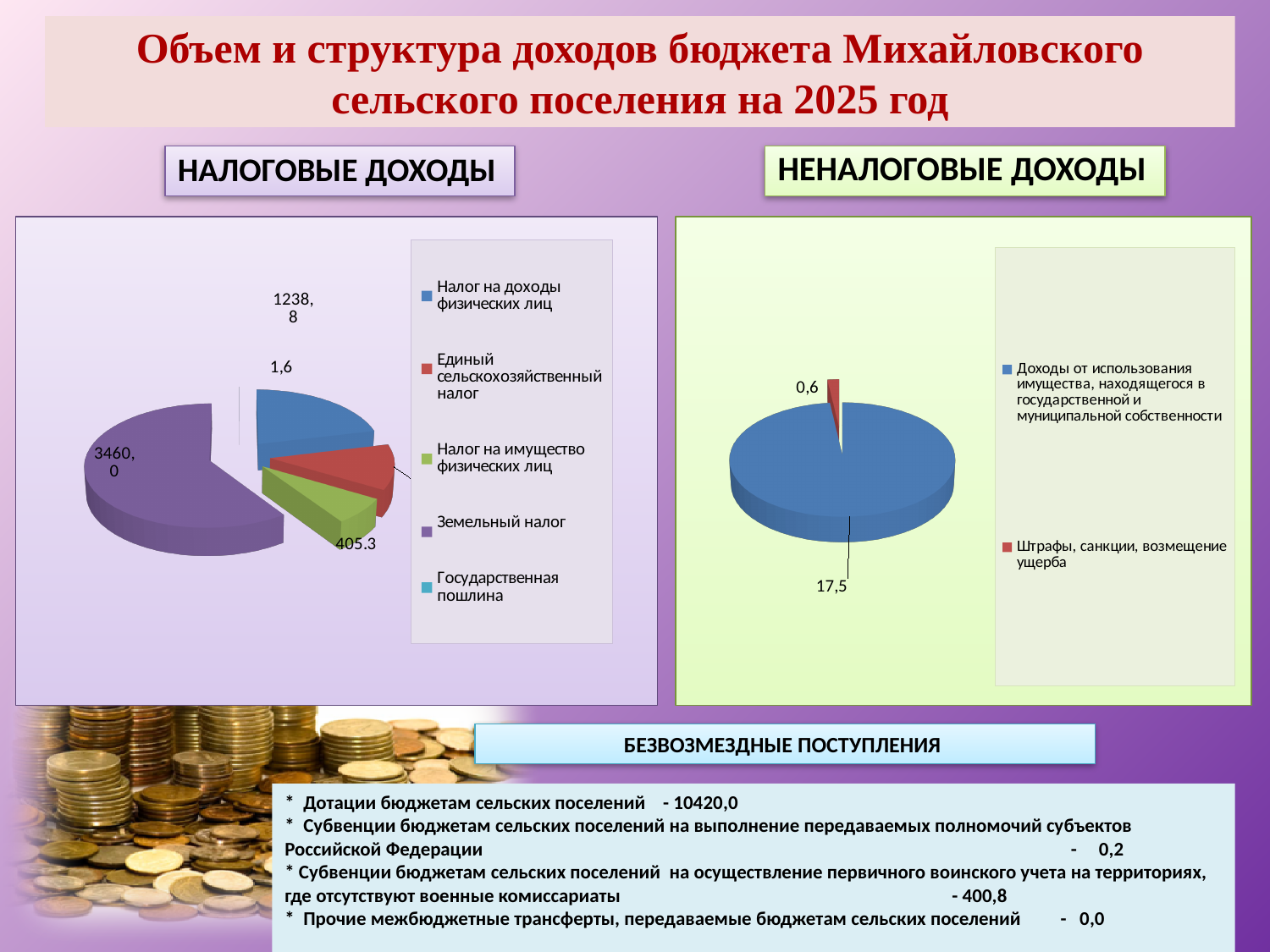
In the НЕНАЛОГОВЫЕ ДОХОДЫ chart, what is the total of the two slices? 18,1 In the НАЛОГОВЫЕ ДОХОДЫ chart, how many entries does the legend list? 5 In the НЕНАЛОГОВЫЕ ДОХОДЫ chart, what is the value for Доходы от использования имущества, находящегося в государственной и муниципальной собственности? 17,5 In the НЕНАЛОГОВЫЕ ДОХОДЫ chart, how many entries does the legend list? 2 In the НАЛОГОВЫЕ ДОХОДЫ chart, which is larger: Земельный налог or Налог на доходы физических лиц? Земельный налог In the НАЛОГОВЫЕ ДОХОДЫ chart, what is the value for Налог на доходы физических лиц? 1238,8 In the НАЛОГОВЫЕ ДОХОДЫ chart, which category has the largest slice? Земельный налог In the НАЛОГОВЫЕ ДОХОДЫ chart, what is the value for Земельный налог? 3460,0 What kind of chart is shown under the heading НАЛОГОВЫЕ ДОХОДЫ? Pie chart In the НЕНАЛОГОВЫЕ ДОХОДЫ chart, which category has the smallest slice? Штрафы, санкции, возмещение ущерба In the НЕНАЛОГОВЫЕ ДОХОДЫ chart, what is the value for Штрафы, санкции, возмещение ущерба? 0,6 In the НАЛОГОВЫЕ ДОХОДЫ chart, what is the difference between Земельный налог and Налог на доходы физических лиц? 2221,2